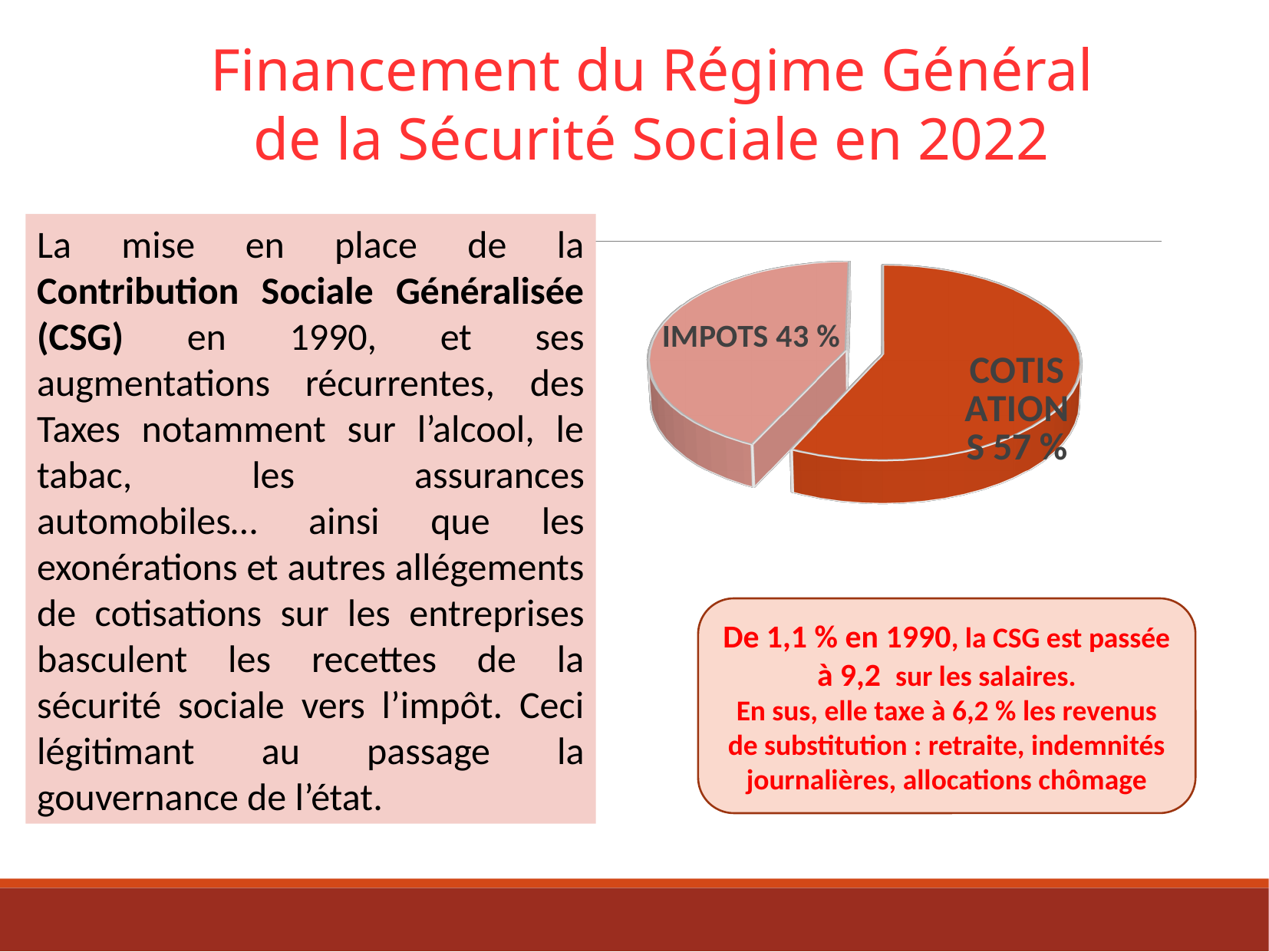
What share of the pie does the COTISATIONS slice represent? 57 % Which is larger in the pie chart, IMPOTS or COTISATIONS? COTISATIONS What kind of chart is shown on the slide? pie chart Which slice of the pie chart is drawn in the darker orange-red colour? COTISATIONS What share of the pie chart is labelled IMPOTS? 43 % Which slice of the pie chart is the largest? COTISATIONS What is the difference in percentage points between the COTISATIONS slice and the IMPOTS slice? 14 How many slices does the pie chart have? 2 Is the share for COTISATIONS greater or less than 50 %? greater What share of the pie chart is labelled COTISATIONS? 57 % Which slice of the pie chart is the smallest? IMPOTS